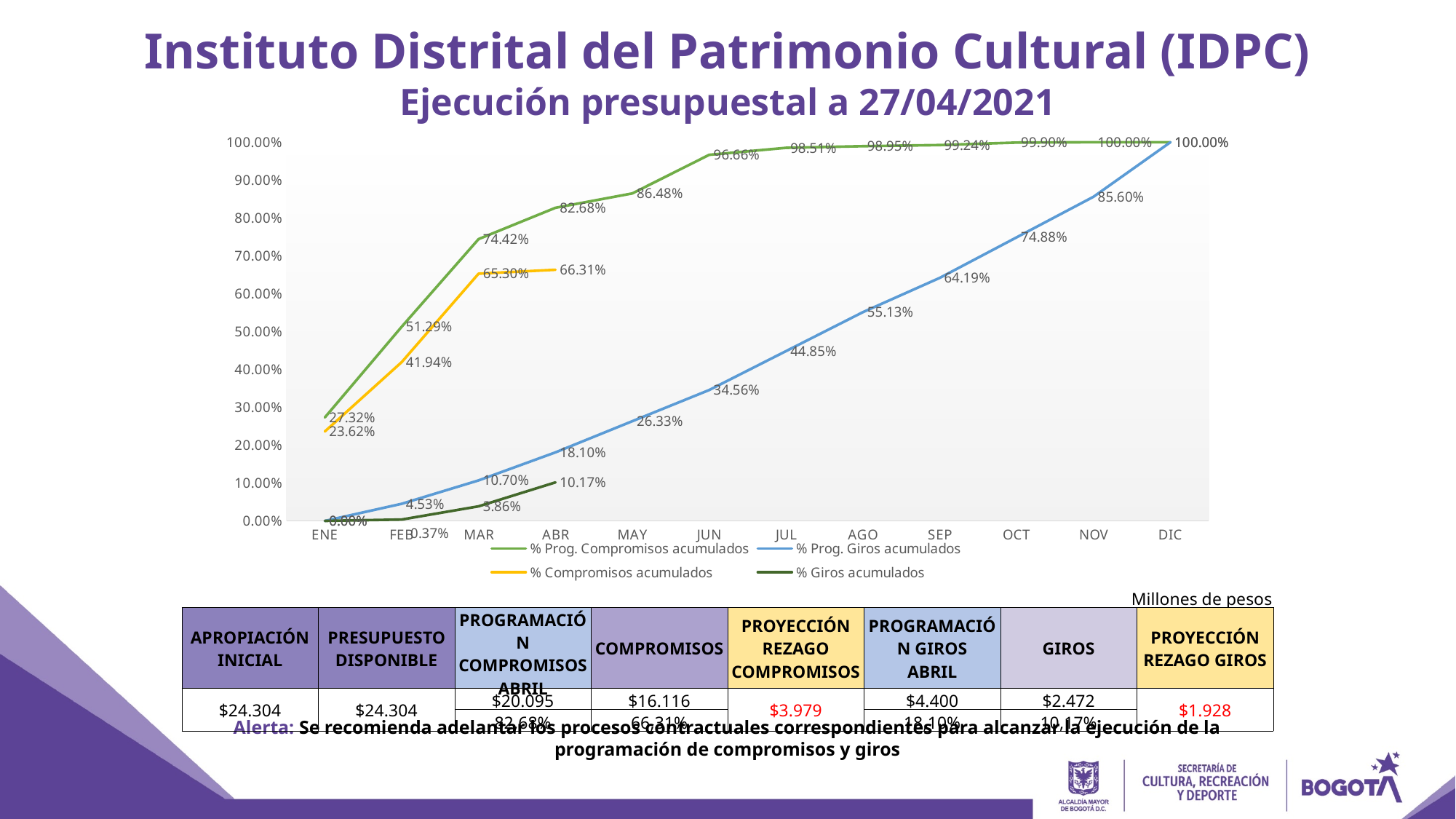
How many series does the chart legend list? 4 Which is larger in MAR: % Prog. Giros acumulados or % Giros acumulados? % Prog. Giros acumulados Does % Prog. Giros acumulados rise or fall from ENE to DIC? rise In which month does % Prog. Giros acumulados reach its highest value? DIC How many months are shown on the x axis of the chart? 12 What is the value of % Giros acumulados in ABR? 10.17% What is the value of % Compromisos acumulados in ABR? 66.31% What type of chart is shown on the slide? line chart What is the value of % Prog. Compromisos acumulados in MAR? 74.42% What is the difference between % Prog. Compromisos acumulados and % Compromisos acumulados in ABR? 16.37% What is the value of % Prog. Giros acumulados in SEP? 64.19% What colour is the line for % Compromisos acumulados? yellow